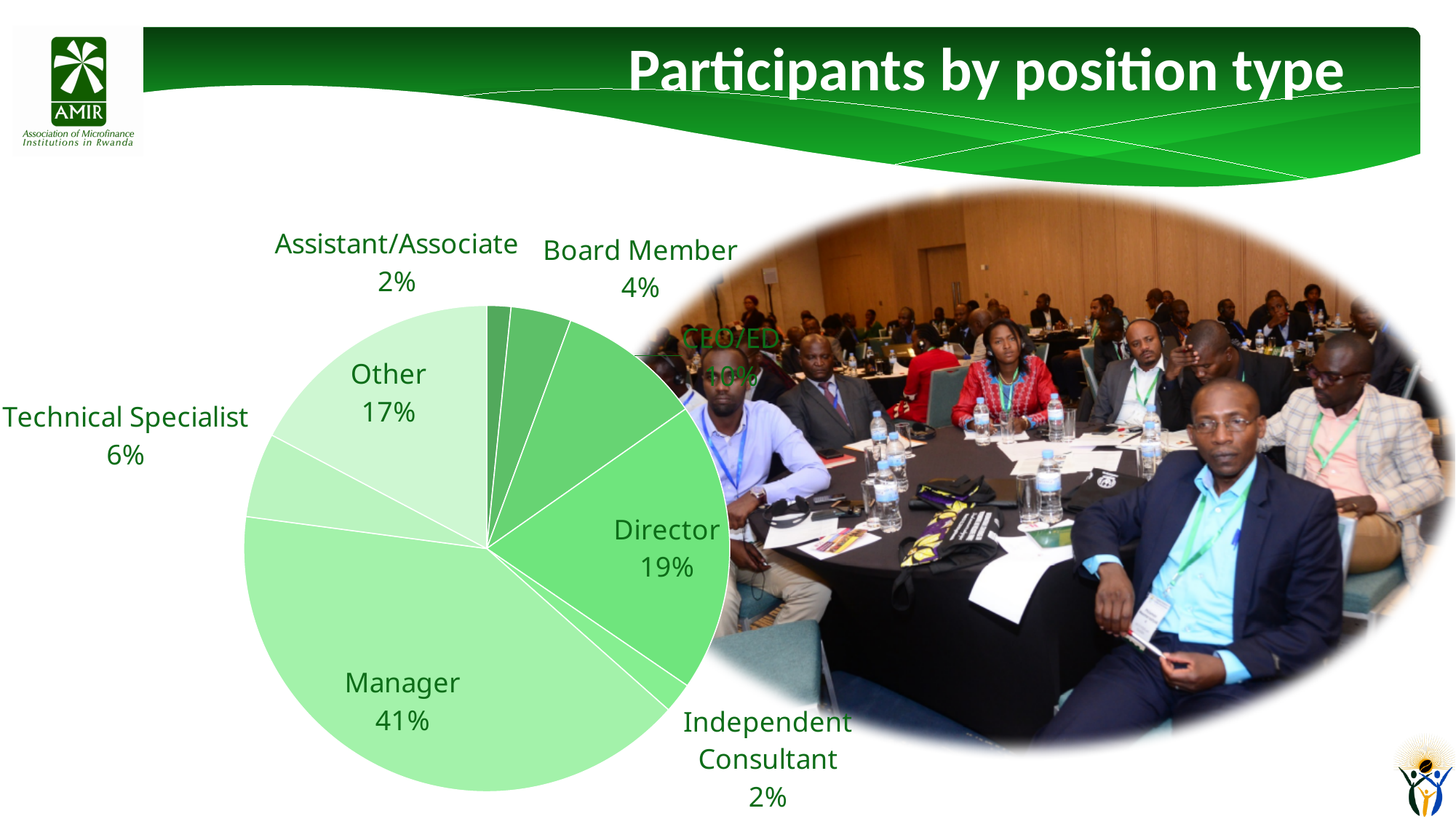
What is the title of the chart? Participants by position type What share of participants are Board Members? 4% How many position types are shown in the pie chart? 8 What is the difference in percentage points between the Manager and Director shares? 22 Which position type has the largest share of participants? Manager What is the combined share of Assistant/Associate and Independent Consultant? 4% What share of participants are Directors? 19% What share of participants are Managers? 41% Which has a larger share, Other or CEO/ED? Other What share of participants are Technical Specialists? 6% What kind of chart is shown on the slide? pie chart What share of participants fall under Other? 17%